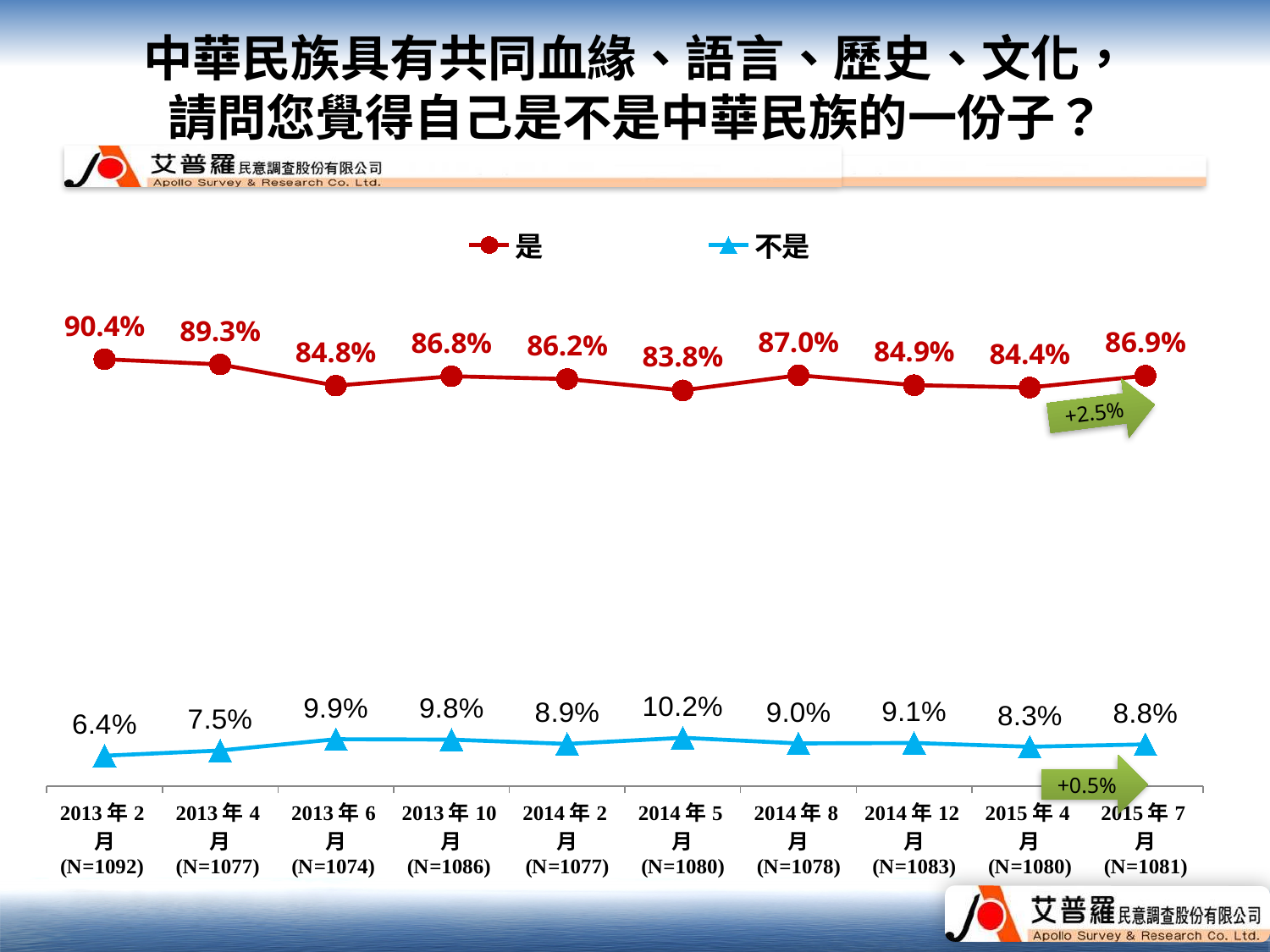
How many time periods are plotted on the x axis? 10 What is the value for 不是 in 2014年5月? 10.2% In which period is the 是 series lowest? 2014年5月 In which period is the 是 series highest? 2013年2月 In which period is the 不是 series lowest? 2013年2月 In which period is the 不是 series highest? 2014年5月 What is the value for 是 in 2013年2月? 90.4% Which is larger for 不是: the value in 2013年6月 or in 2015年4月? 2013年6月 What kind of chart is shown on the slide? Line chart What is the value for 是 in 2015年7月? 86.9% What is the difference between the 是 values in 2015年4月 and 2015年7月? 2.5% How many series does the legend list? 2